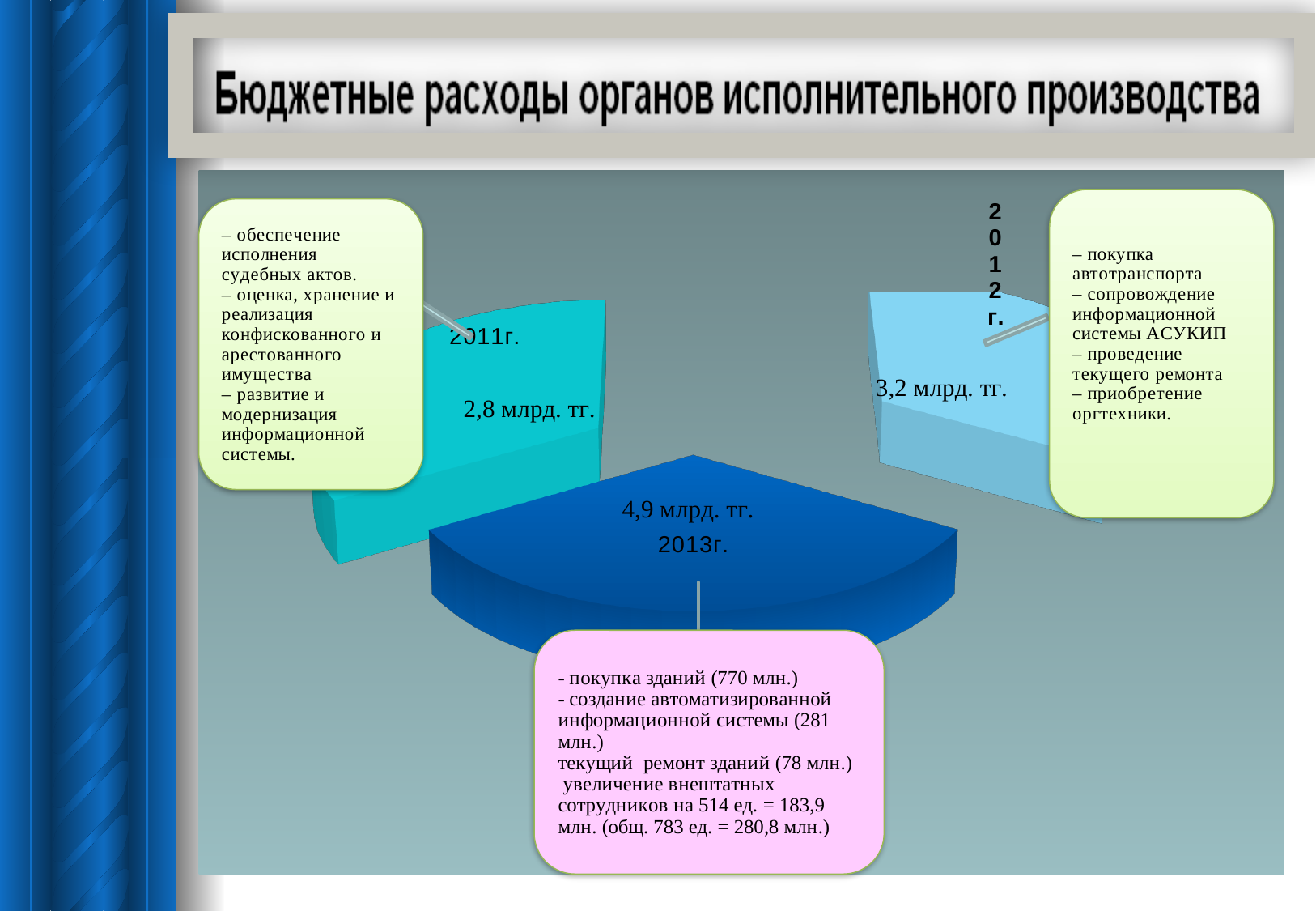
Which year has the lowest budget expenditure? 2011 Do the budget expenditures rise or fall from 2011 to 2013? Rise What is the value shown for 2011? 2,8 млрд. тг. What is the value shown for 2013? 4,9 млрд. тг. How many slices does the pie chart have? 3 Which is larger, the value for 2012 or the value for 2011? 2012 What is the difference between the values for 2013 and 2011? 2,1 млрд. тг. What is the value shown for 2012? 3,2 млрд. тг. What is the title of the slide? Бюджетные расходы органов исполнительного производства What kind of chart is shown on the slide? Pie chart What is the difference between the values for 2012 and 2011? 0,4 млрд. тг. Which year has the highest budget expenditure? 2013